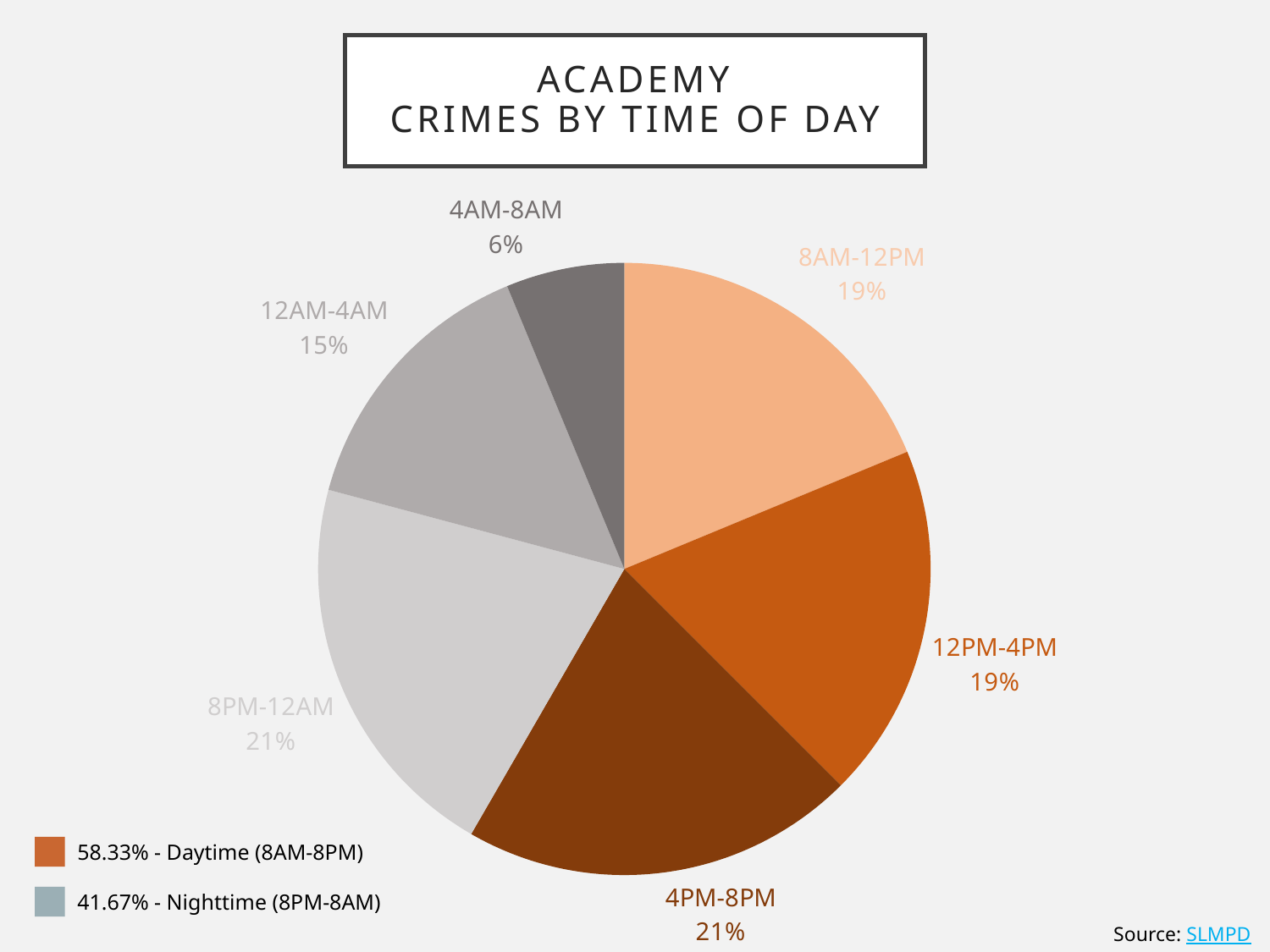
What share of crimes occurred between 4PM and 8PM? 21% What share of crimes occurred between 8AM and 12PM? 19% What is the difference in percentage points between the 8PM-12AM slice and the 12AM-4AM slice? 6 Which time-of-day slice has the smallest share of crimes? 4AM-8AM What type of chart is shown on the slide? pie chart What is the title of the chart? Academy Crimes by Time of Day What share of crimes occurred between 4AM and 8AM? 6% According to the legend, what percentage of crimes occurred during daytime (8AM-8PM)? 58.33% What is the combined share of the 8PM-12AM and 12AM-4AM slices? 36% What share of crimes occurred between 12AM and 4AM? 15% How many time-of-day slices does the pie chart have? 6 Which slice is larger, 12PM-4PM or 4AM-8AM? 12PM-4PM